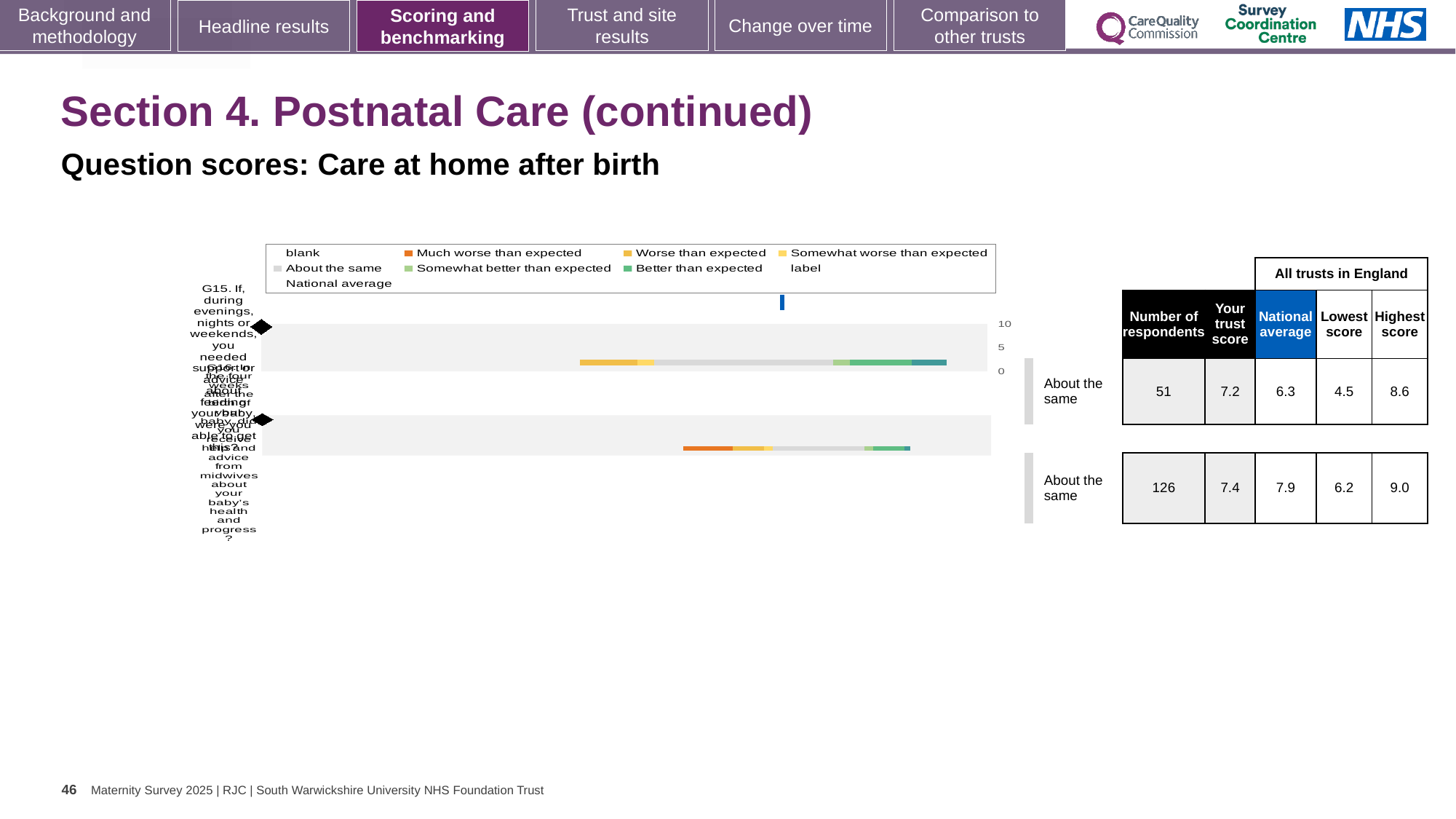
Which question has more respondents, the first (top) or the second (bottom)? second (bottom), 126 What benchmark category is shown beside both question bars? About the same In the table next to the chart, what is the national average for the first (top) question? 6.3 In the table next to the chart, what is the number of respondents for the first (top) question? 51 How many question bars are plotted in the chart? 2 What kind of chart is shown on the slide? bar chart In the table next to the chart, what is the trust score for the second (bottom) question? 7.4 For the second (bottom) question, which is larger: the trust score or the national average? national average In the table next to the chart, what is the highest score for the second (bottom) question? 9.0 In the table next to the chart, what is the lowest score for the first (top) question? 4.5 For the first (top) question, which is larger: the trust score or the national average? trust score For the second (bottom) question, what is the difference between the highest score and the lowest score? 2.8